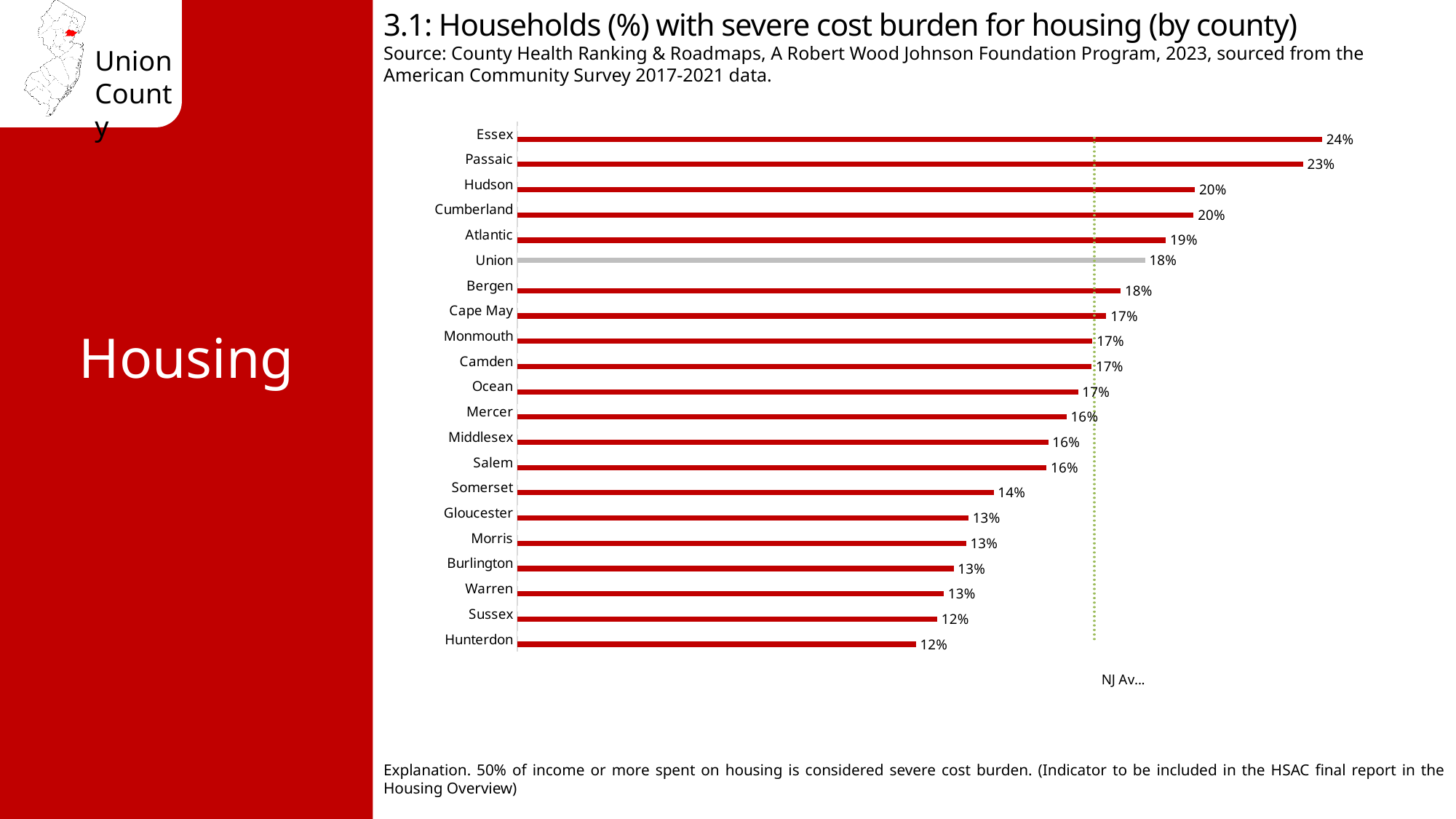
Which county's bar is shown in grey rather than red? Union What is the value for Somerset County? 14% Which has a larger value, Atlantic or Union? Atlantic What is the value for Union County? 18% Which has a larger value, Somerset or Gloucester? Somerset What is the value for Passaic County? 23% What kind of chart is shown on the slide? Bar chart What is the difference between the values for Essex and Union? 6 percentage points What is the value for Essex County? 24% How many counties are shown in the chart? 21 Which county has the highest percentage of households with severe cost burden? Essex What is the difference between the values for Essex and Hunterdon? 12 percentage points